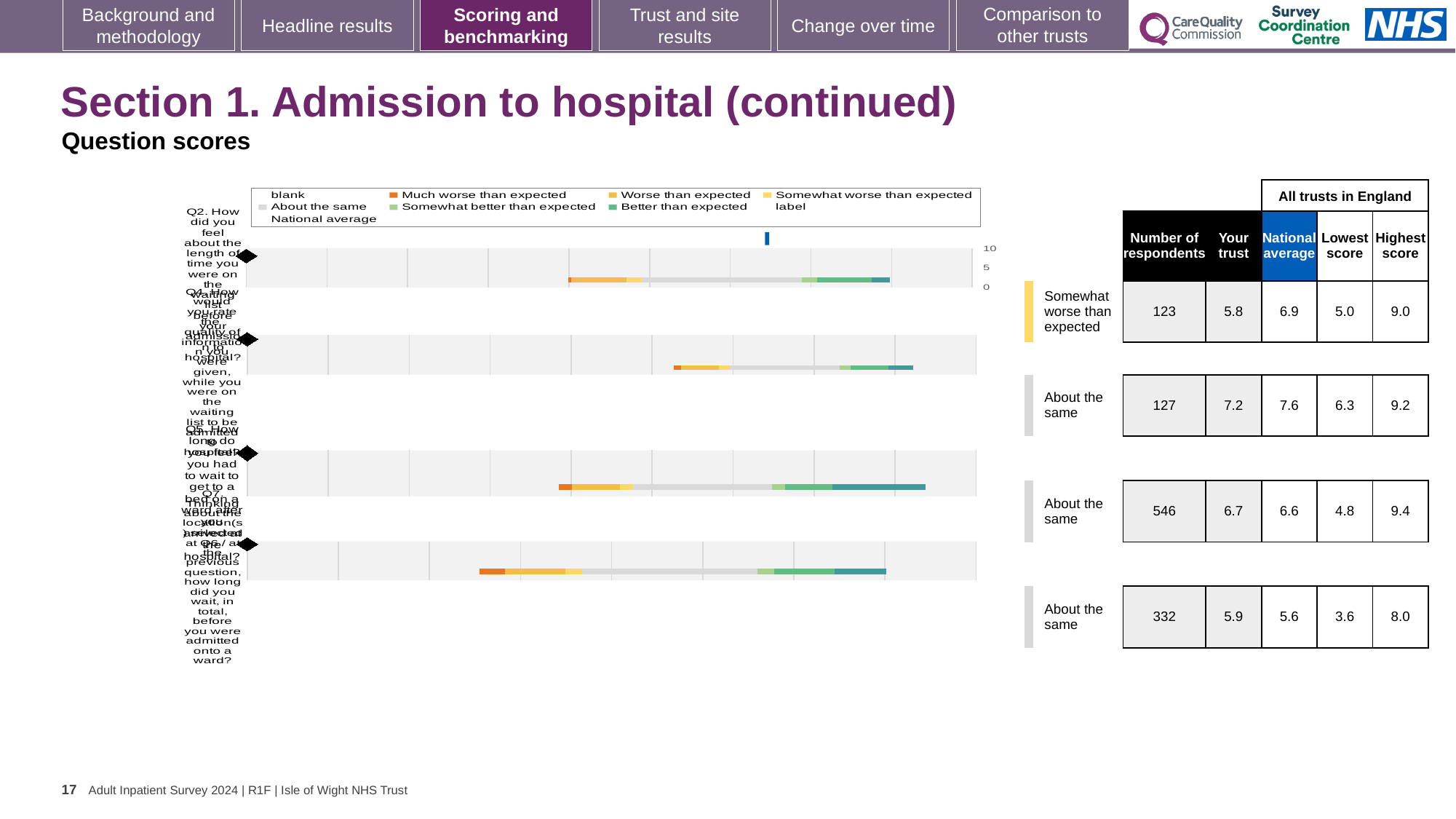
For the second row, what is the difference between the highest score and the lowest score? 2.9 What colour does the legend use for 'Much worse than expected'? orange Which row of the chart has the largest number of respondents? the third row (546) How many question rows (bars) does the chart show? 4 What is the highest value shown on the chart's score axis? 10 How many rows of the chart are rated 'About the same'? 3 What benchmark category is given for the top row of the chart? Somewhat worse than expected What does the blue marker in the chart legend represent? National average What kind of chart is shown on the slide? bar chart What is the number of respondents for the top row of the chart? 123 What is the 'Your trust' score for the second row of the chart? 7.2 For the top row, which is larger: the 'Your trust' score or the national average? National average